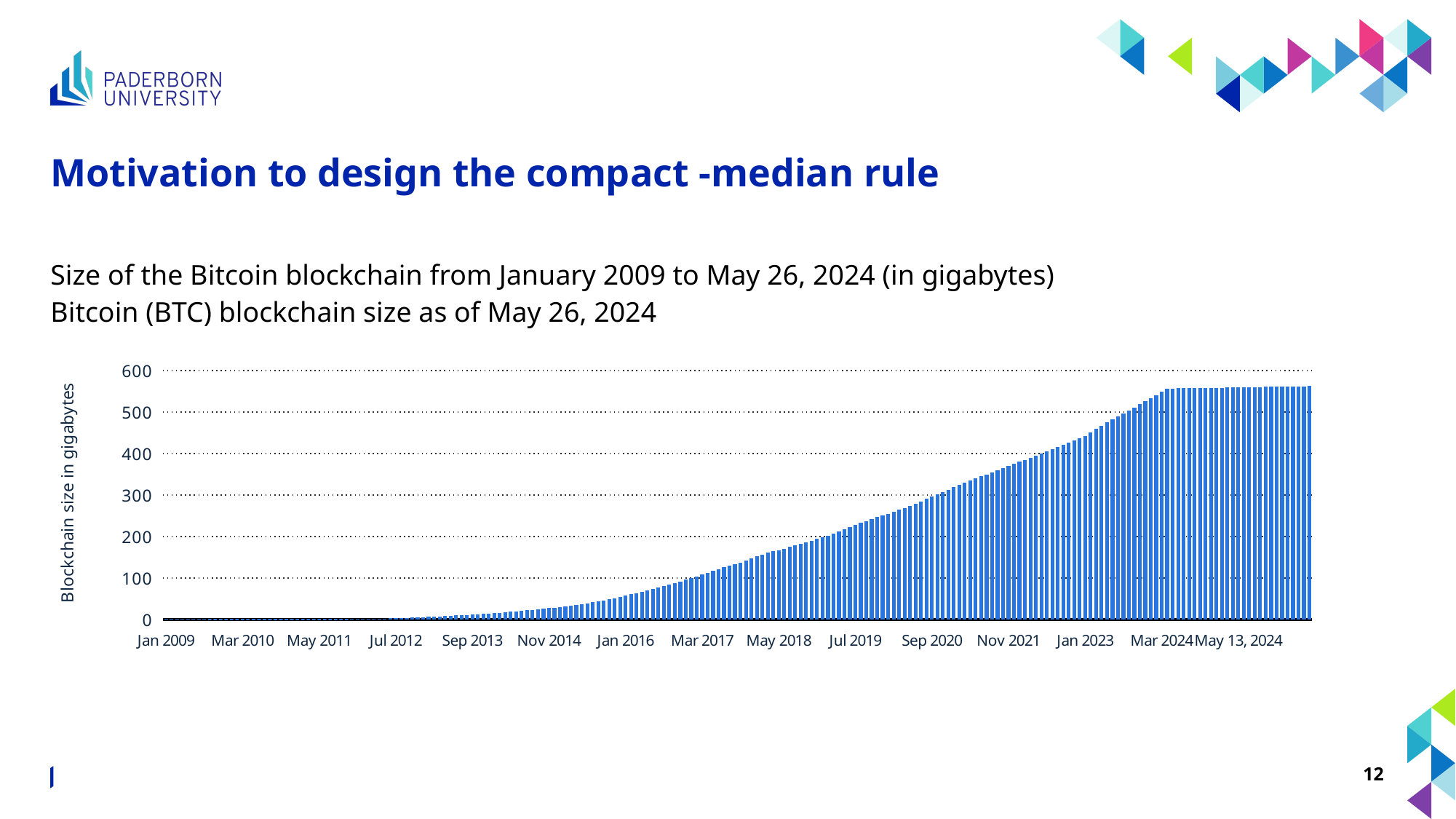
What is the label of the y axis? Blockchain size in gigabytes Is the blockchain size for Mar 2024 greater or less than 500? greater How many date labels are shown on the x axis? 15 Do the blockchain size values rise or fall from Jan 2009 to May 2024 along the x axis? rise Which is larger, the blockchain size for Jan 2023 or for Jul 2019? Jan 2023 Is the blockchain size for Jul 2019 greater or less than 300? less Which labelled date on the x axis has the lowest blockchain size? Jan 2009 Is the blockchain size for Jan 2016 greater or less than 100? less What kind of chart is shown on the slide? bar chart